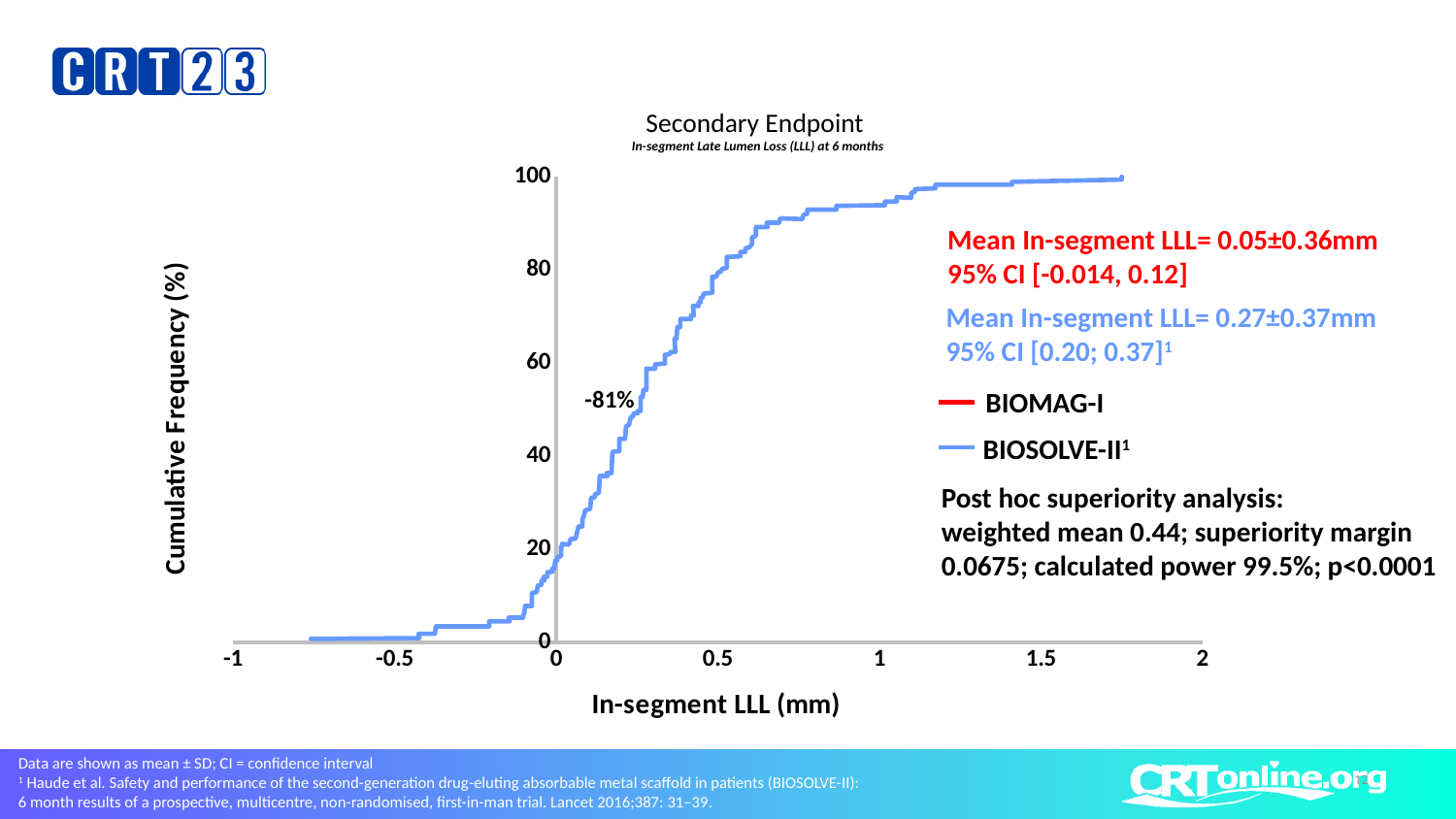
How many series does the legend list? 2 What kind of chart is shown on the slide? line chart Is the cumulative frequency of the plotted curve at an In-segment LLL of 0 mm greater or less than 40? less Does the plotted cumulative frequency curve rise or fall as In-segment LLL increases along the x axis? rise What is the mean In-segment LLL reported for BIOSOLVE-II on the slide? 0.27±0.37mm How many labelled tick marks are on the x axis? 7 What is the mean In-segment LLL reported for BIOMAG-I on the slide? 0.05±0.36mm Is the cumulative frequency of the plotted curve at an In-segment LLL of -0.5 mm greater or less than 20? less What is the title of the chart? Secondary Endpoint Is the cumulative frequency of the plotted curve at an In-segment LLL of 1 mm greater or less than 80? greater Which series is drawn in blue according to the legend? BIOSOLVE-II